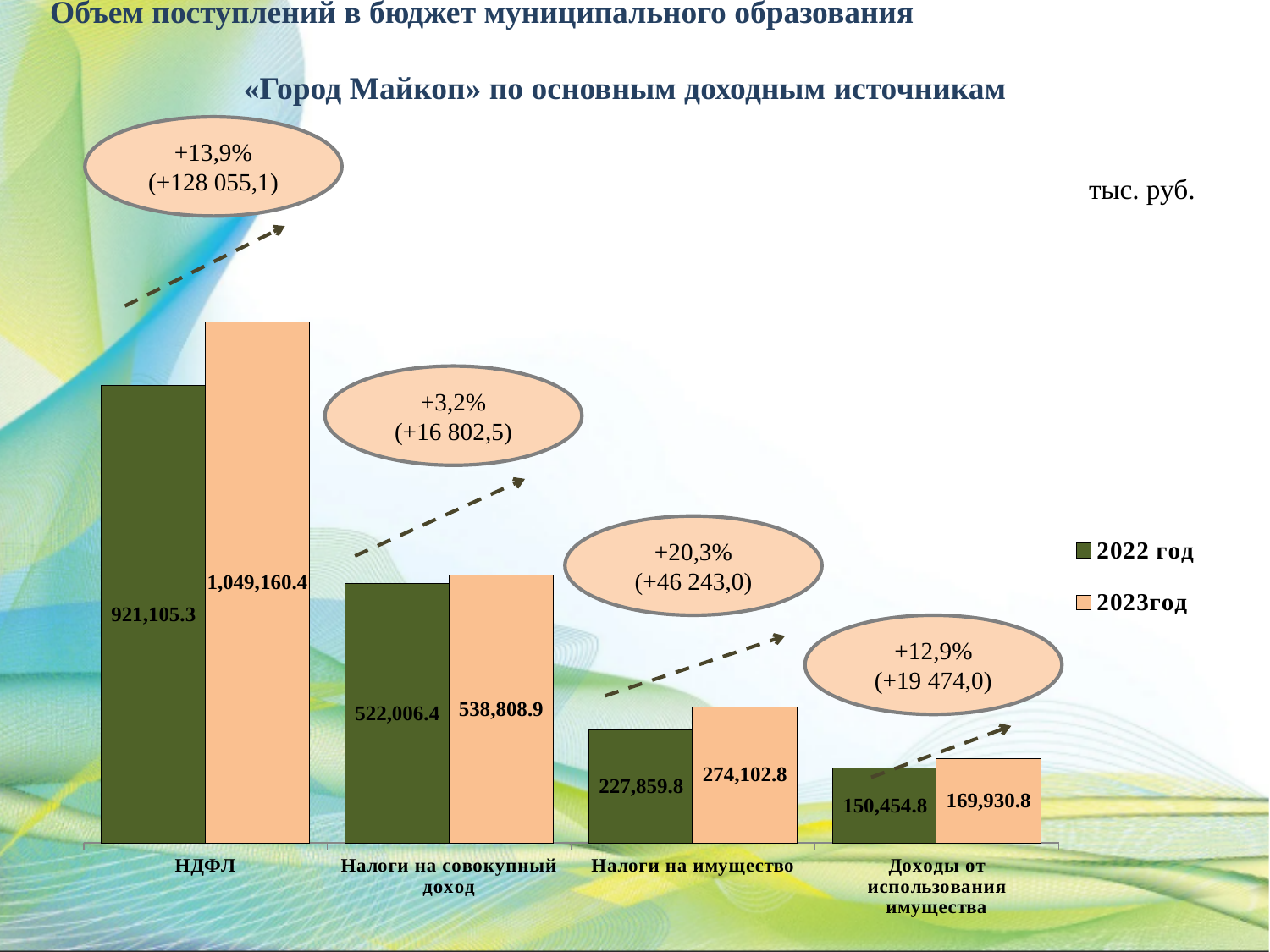
How many categories are shown on the x axis? 4 What is the value for Доходы от использования имущества in 2022 год? 150,454.8 What is the value for НДФЛ in 2022 год? 921,105.3 Which category has the lowest value in 2022 год? Доходы от использования имущества How many series does the legend list? 2 Which is larger for Налоги на совокупный доход: the 2022 год value or the 2023год value? 2023год What is the value for Налоги на имущество in 2023год? 274,102.8 What is the difference between the 2023год and 2022 год values for НДФЛ? 128,055.1 What is the value for НДФЛ in 2023год? 1,049,160.4 What kind of chart is shown on the slide? Bar chart Which category has the highest value in 2023год? НДФЛ What is the difference between the 2023год and 2022 год values for Налоги на имущество? 46,243.0